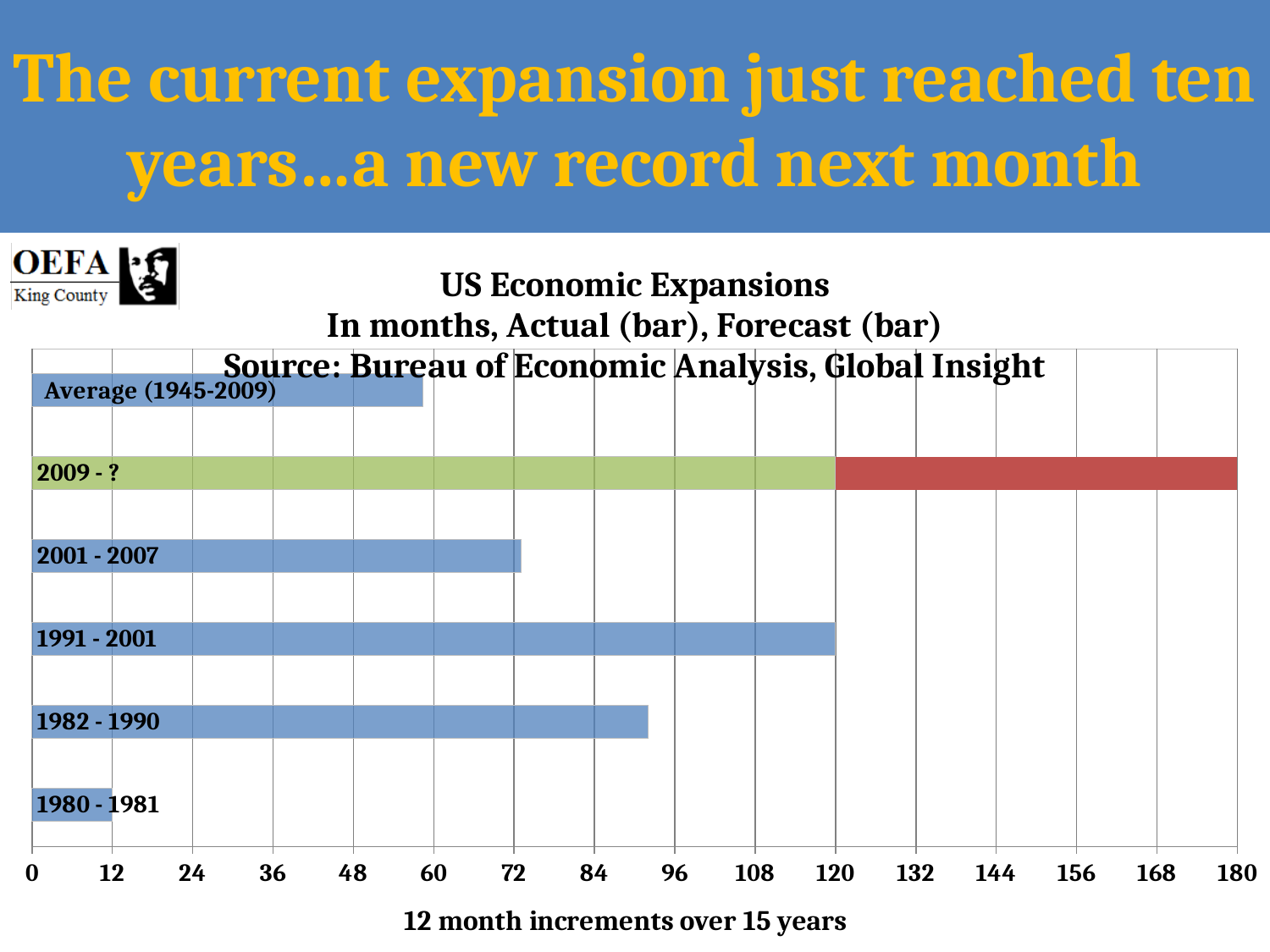
Is the value for 1982 - 1990 greater or less than 84? greater Which bar is longer, 1982 - 1990 or 2001 - 2007? 1982 - 1990 Which bar is longer, Average (1945-2009) or 1991 - 2001? 1991 - 2001 Is the value for Average (1945-2009) greater or less than 60? less What is the label shown below the horizontal axis of the chart? 12 month increments over 15 years How many months does the bar for 1991 - 2001 reach on the axis? 120 Which category has the longest bar on the chart? 2009 - ? What kind of chart is shown on the slide? bar chart Is the value for 2001 - 2007 greater or less than 84? less How many months does the bar for 1980 - 1981 reach on the axis? 12 How many expansion categories are plotted on the chart? 6 Which category has the shortest bar on the chart? 1980 - 1981